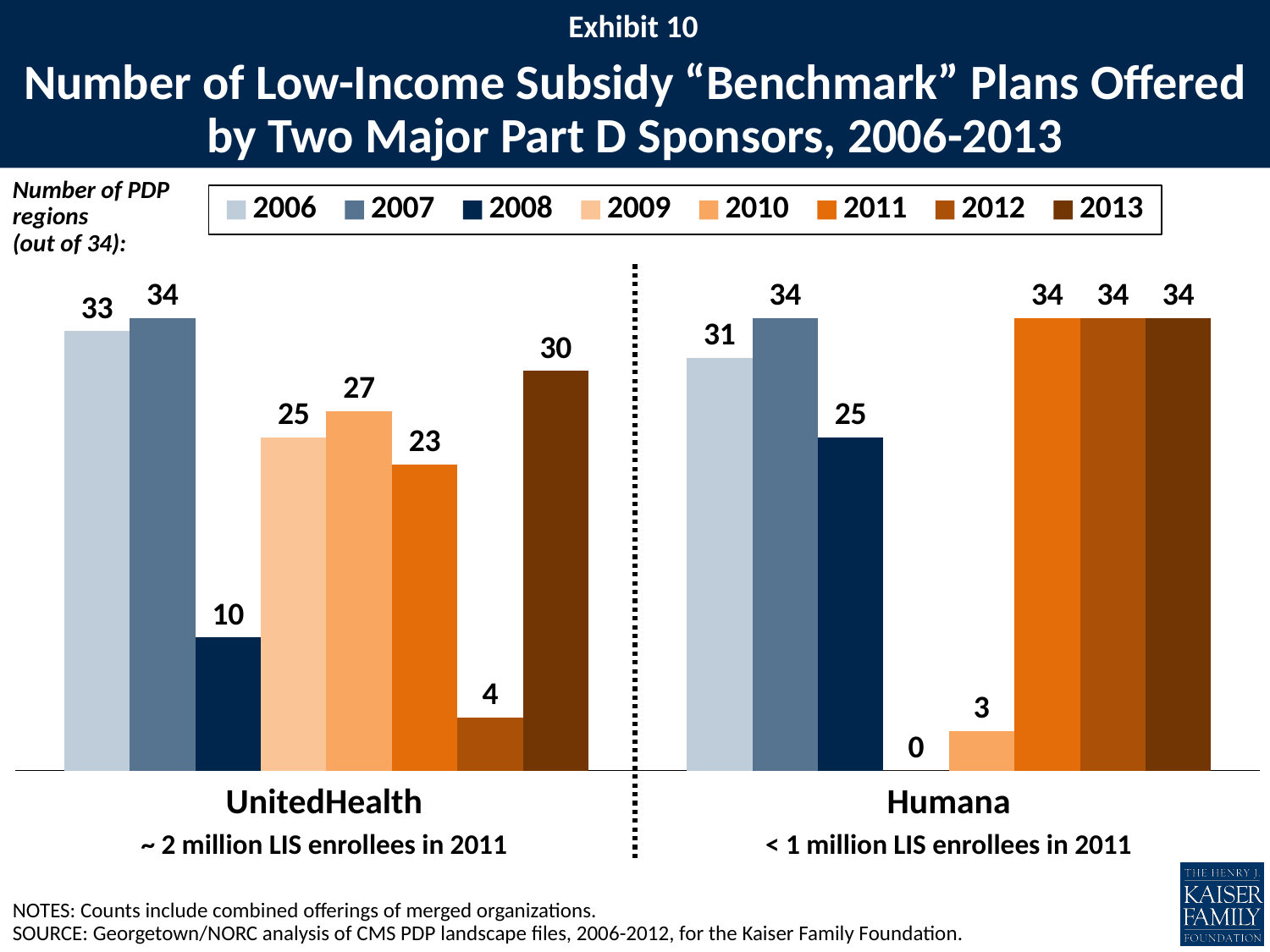
What is the value for Humana in 2009? 0 What is the value for Humana in 2010? 3 Which year has the highest value for UnitedHealth? 2007 What is the difference between the Humana values for 2008 and 2010? 22 Which is larger, the 2011 value for UnitedHealth or the 2011 value for Humana? Humana How many sponsors (categories) are shown on the x axis? 2 What kind of chart is shown on the slide? Bar chart Which year has the lowest value for UnitedHealth? 2012 What is the difference between the UnitedHealth values for 2013 and 2012? 26 What is the value for UnitedHealth in 2013? 30 How many series does the legend list? 8 How many plans did UnitedHealth offer in 2008? 10